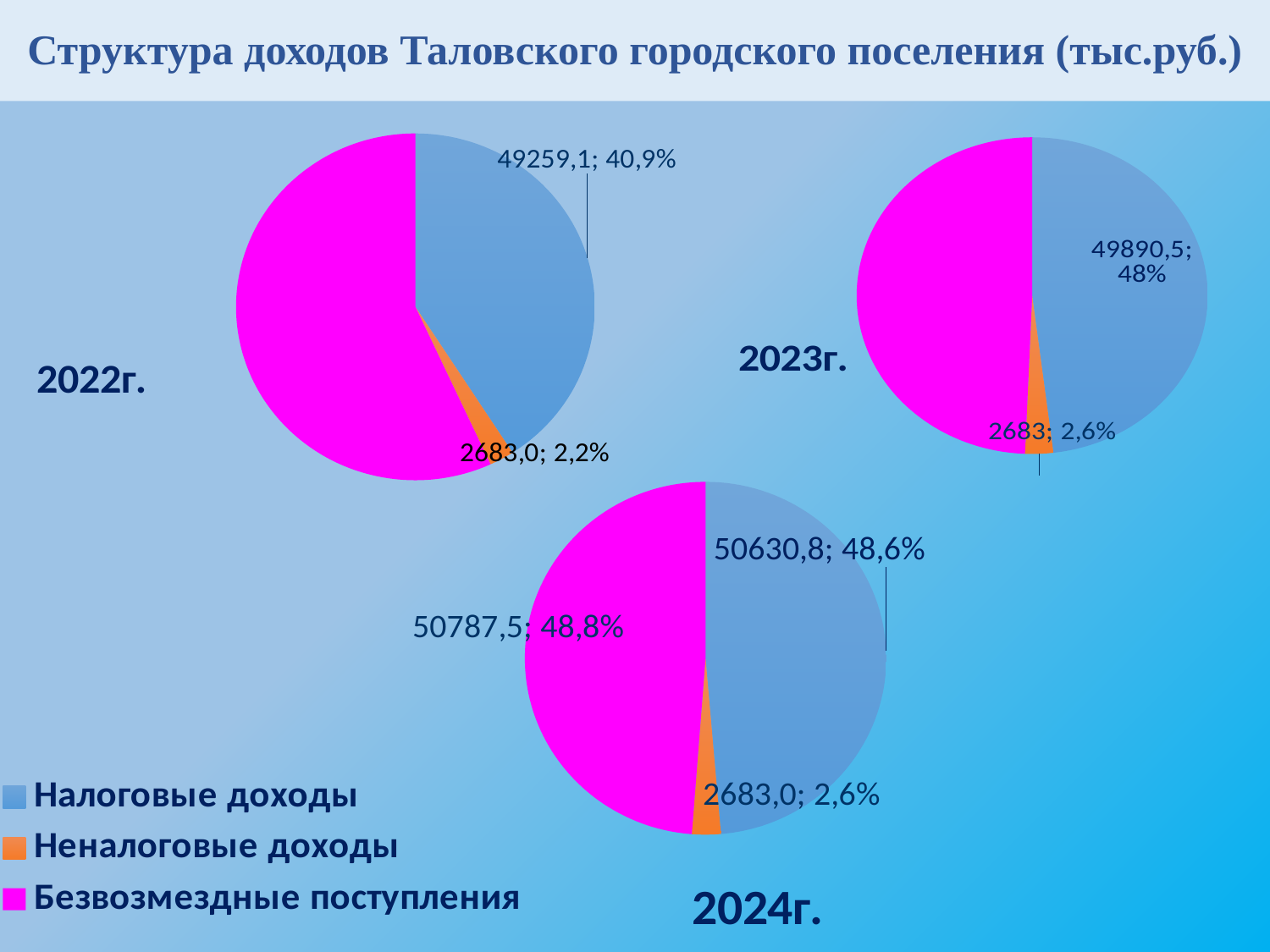
In the 2022 pie chart, what share of the pie is Неналоговые доходы? 2,2% In the 2024 pie chart, what share of the pie is Налоговые доходы? 48,6% In the 2024 pie chart, which category has the smallest slice? Неналоговые доходы In the 2022 pie chart, what is the value for Налоговые доходы? 49259,1 In the 2023 pie chart, what is the value for Неналоговые доходы? 2683 How many categories does the legend list? 3 How many pie charts are on the slide? 3 What is the difference between the Налоговые доходы value in the 2024 pie chart and in the 2023 pie chart? 740,3 In the 2024 pie chart, what is the value for Безвозмездные поступления? 50787,5 What type of charts are shown on the slide? Pie charts In the 2022 pie chart, which category has the largest slice? Безвозмездные поступления In the 2023 pie chart, what share of the pie is Налоговые доходы? 48%